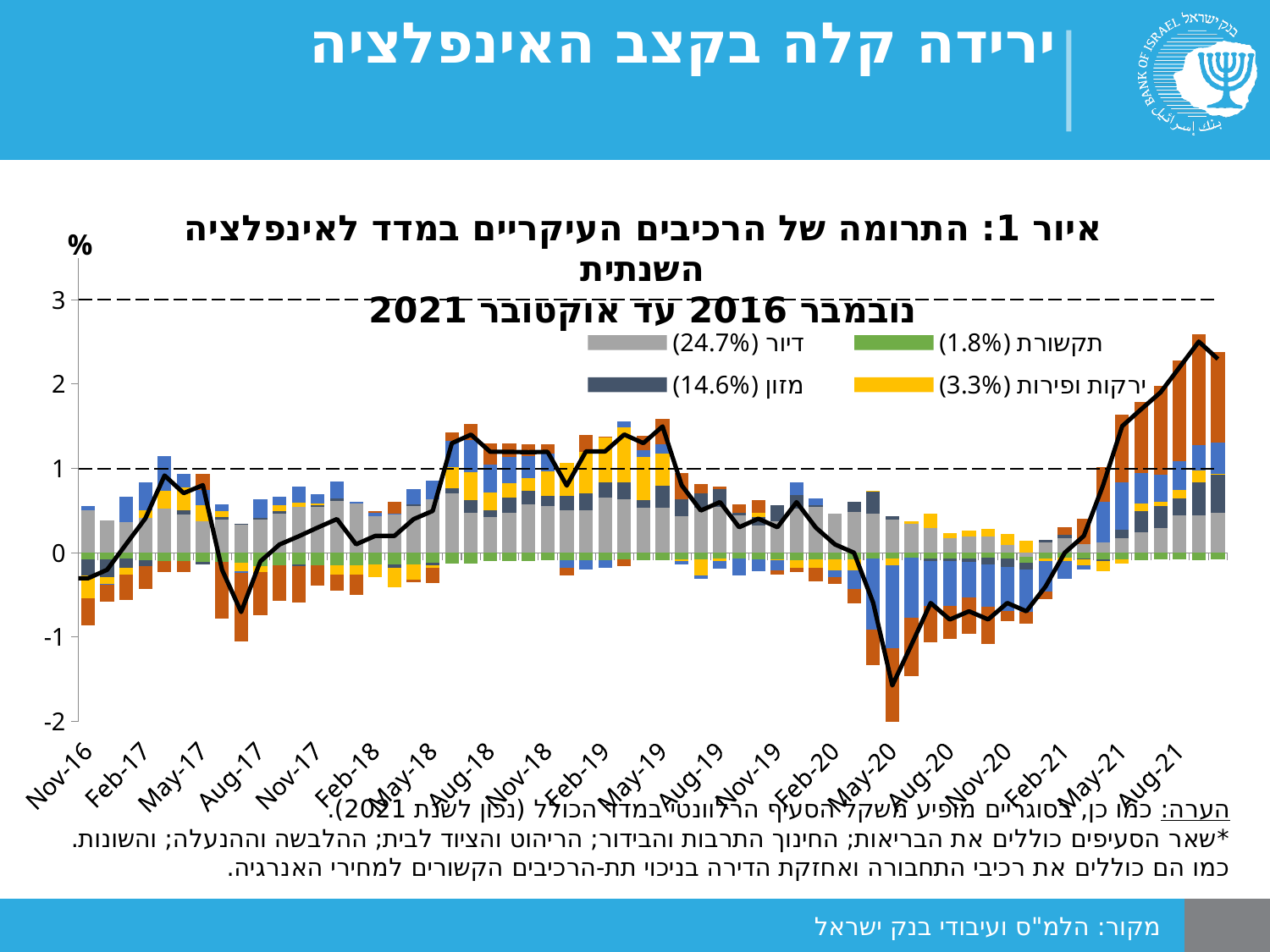
Is the value of the line at Nov-16 greater or less than 0? less Is the value of the line at Aug-21 greater or less than 1? greater Is the line value at Aug-18 higher or lower than at Aug-20? higher According to the legend, what percentage is shown next to מזון? 14.6% Does the line rise or fall between Feb-21 and Aug-21? rise What kind of chart is shown on the slide? combination bar and line chart Does the line rise or fall between Feb-20 and May-20? fall According to the legend, what percentage is shown next to דיור? 24.7% In which year does the line reach its lowest point, 2017 or 2020? 2020 Is the value of the line at Aug-18 greater or less than 1? greater